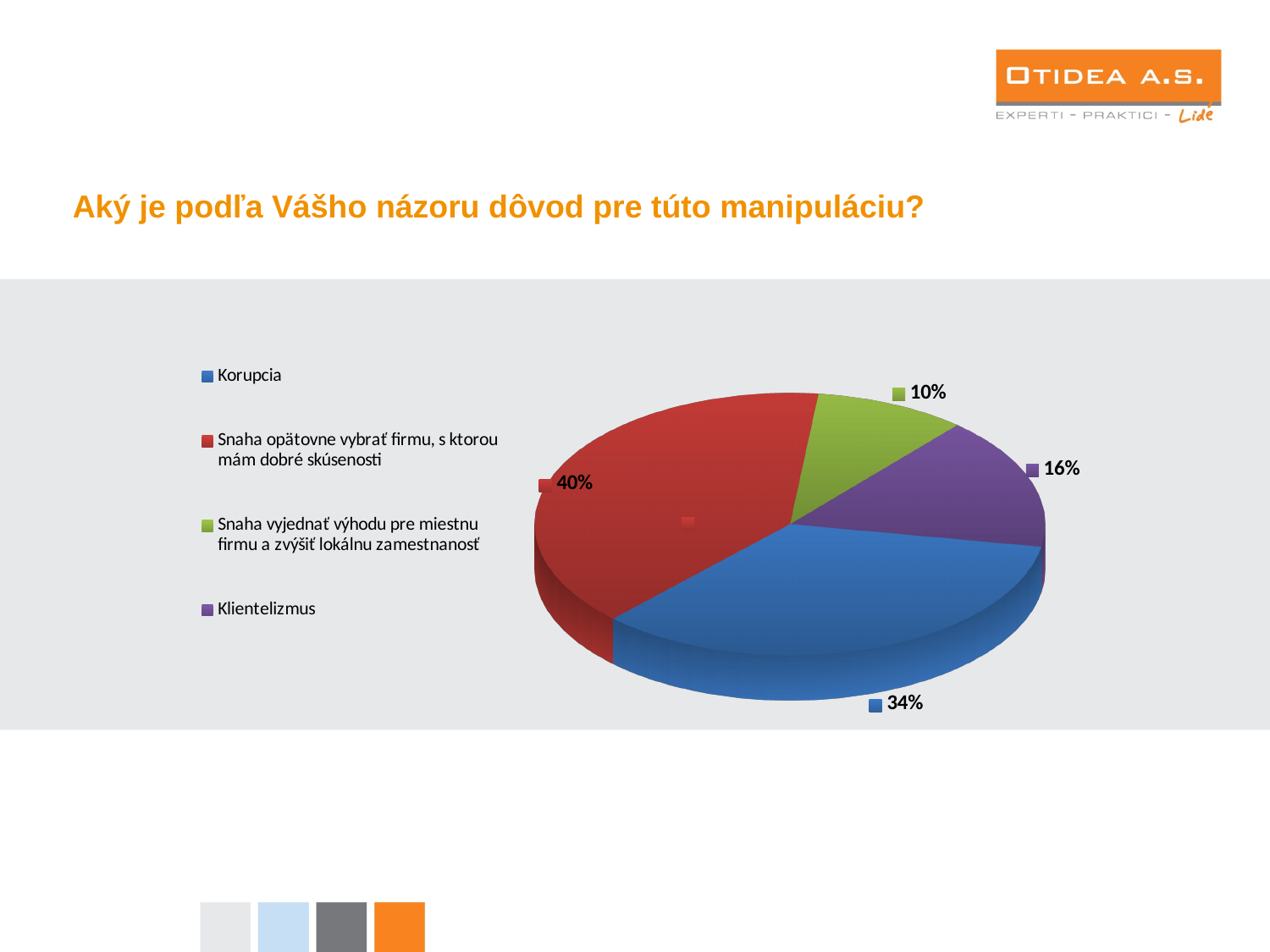
What share of the pie does 'Snaha vyjednať výhodu pre miestnu firmu a zvýšiť lokálnu zamestnanosť' have? 10% What share of the pie does 'Snaha opätovne vybrať firmu, s ktorou mám dobré skúsenosti' have? 40% Which category has the largest slice of the pie? Snaha opätovne vybrať firmu, s ktorou mám dobré skúsenosti What share of the pie does Korupcia have? 34% What kind of chart is shown on the slide? pie chart What is the title of the slide above the chart? Aký je podľa Vášho názoru dôvod pre túto manipuláciu? What is the difference in percentage points between the Korupcia slice and the Klientelizmus slice? 18 How many categories does the pie chart have? 4 What share of the pie does Klientelizmus have? 16% Which category has the smallest slice of the pie? Snaha vyjednať výhodu pre miestnu firmu a zvýšiť lokálnu zamestnanosť What colour is the Korupcia slice? blue Which is larger, the Korupcia slice or the Klientelizmus slice? Korupcia